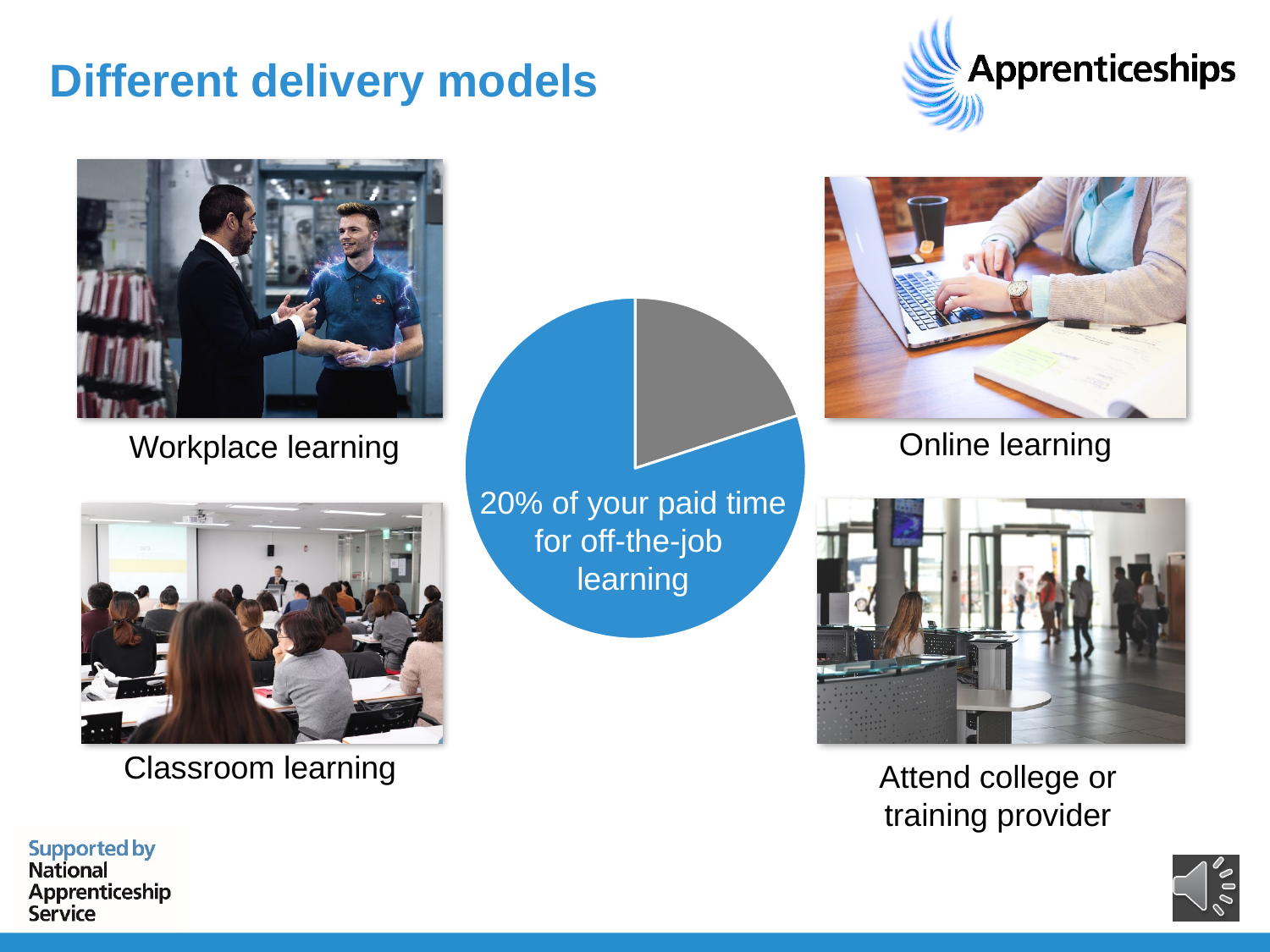
How many slices does the pie chart have? 2 Which slice of the pie chart is larger, the blue one or the grey one? blue Which slice of the pie chart is the smallest? the grey slice Is the blue slice of the pie chart greater or less than 50% of the pie? greater What two colours are used for the slices of the pie chart? blue and grey What text is written on the pie chart? 20% of your paid time for off-the-job learning Is the grey slice of the pie chart greater or less than 50% of the pie? less What kind of chart is shown in the centre of the slide? pie chart According to the text on the pie chart, what percentage of your paid time is for off-the-job learning? 20%